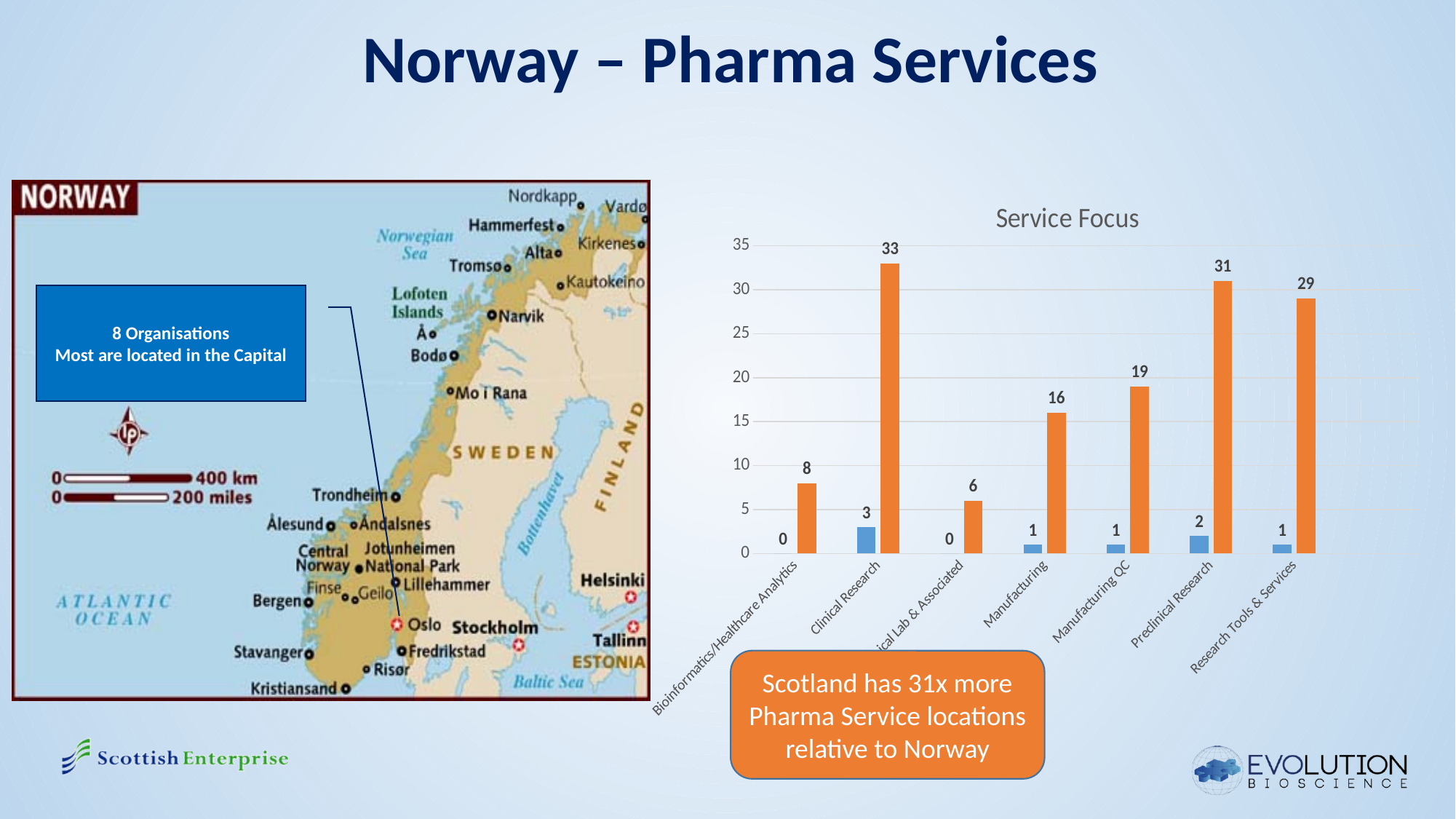
In the Service Focus chart, what is the value of the orange bar for Clinical Research? 33 In the Service Focus chart, which category has the highest orange bar? Clinical Research In the Service Focus chart, what is the value of the blue bar for Preclinical Research? 2 In the Service Focus chart, is the orange bar for Research Tools & Services greater or less than 25? greater What kind of chart is the "Service Focus" chart? Bar chart In the Service Focus chart, what is the value of the orange bar for Bioinformatics/Healthcare Analytics? 8 In the Service Focus chart, what is the value of the blue bar for Clinical Research? 3 In the Service Focus chart, what is the difference between the orange bars for Preclinical Research and Research Tools & Services? 2 What is the title of the chart on the right of the slide? Service Focus In the Service Focus chart, what is the value of the orange bar for Manufacturing QC? 19 How many categories are shown on the x axis of the Service Focus chart? 7 In the Service Focus chart, which has the larger orange bar: Manufacturing or Manufacturing QC? Manufacturing QC